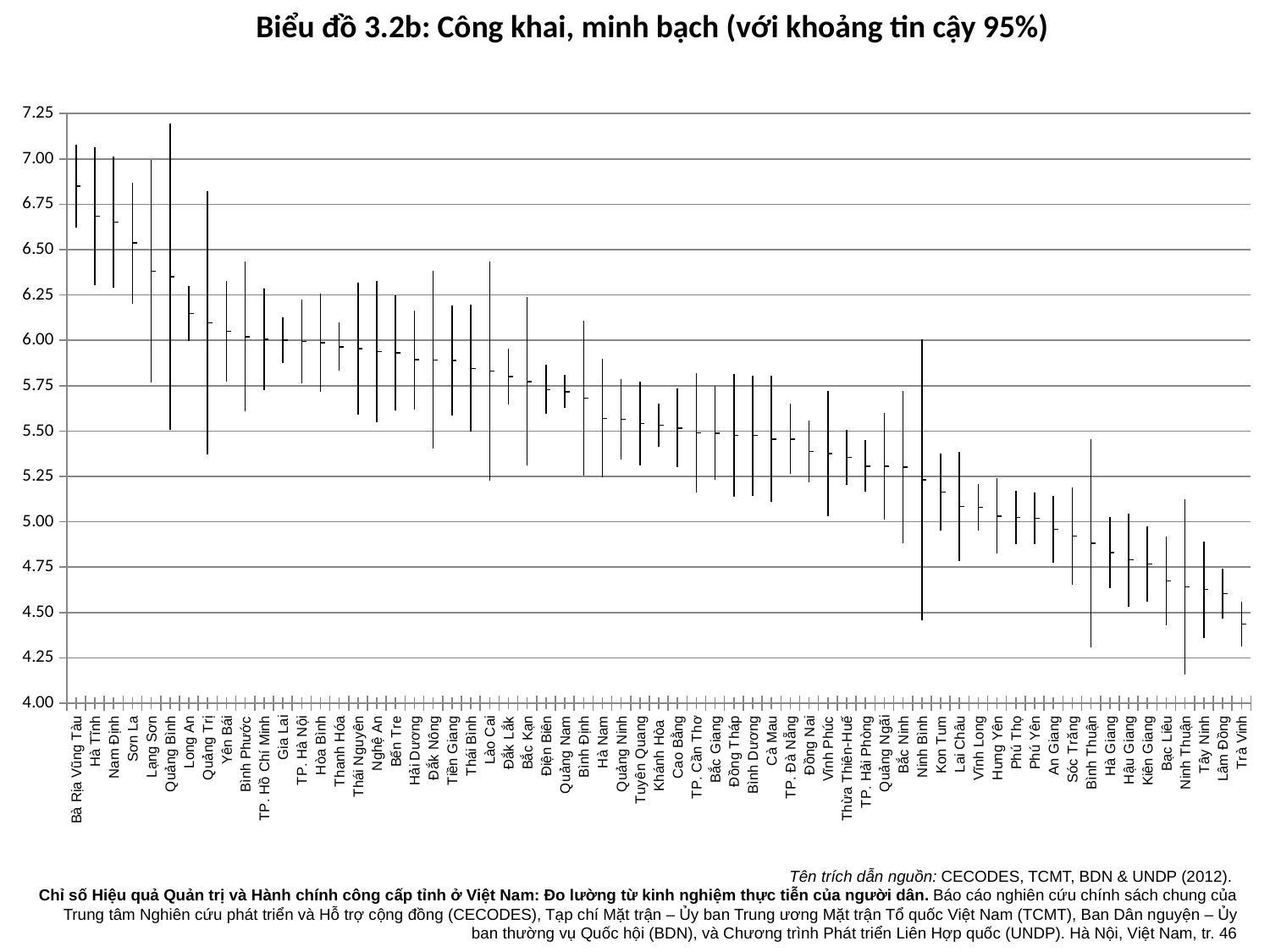
Which has the larger value, Quảng Bình or Kon Tum? Quảng Bình Which has the larger value, Trà Vinh or Hà Tĩnh? Hà Tĩnh Which province has the highest value in the chart? Bà Rịa Vũng Tàu Do the values rise or fall moving from left to right along the x axis? fall Is the value for Bà Rịa Vũng Tàu greater or less than 6.50? greater How many provinces are shown along the x axis of the chart? 63 Is the value for Hà Tĩnh greater or less than 6.50? greater What is the title of the chart? Biểu đồ 3.2b: Công khai, minh bạch (với khoảng tin cậy 95%) What are the lowest and highest values shown on the y axis? 4.00 and 7.25 Which province has the lowest value in the chart? Trà Vinh Is the value for Trà Vinh greater or less than 4.75? less